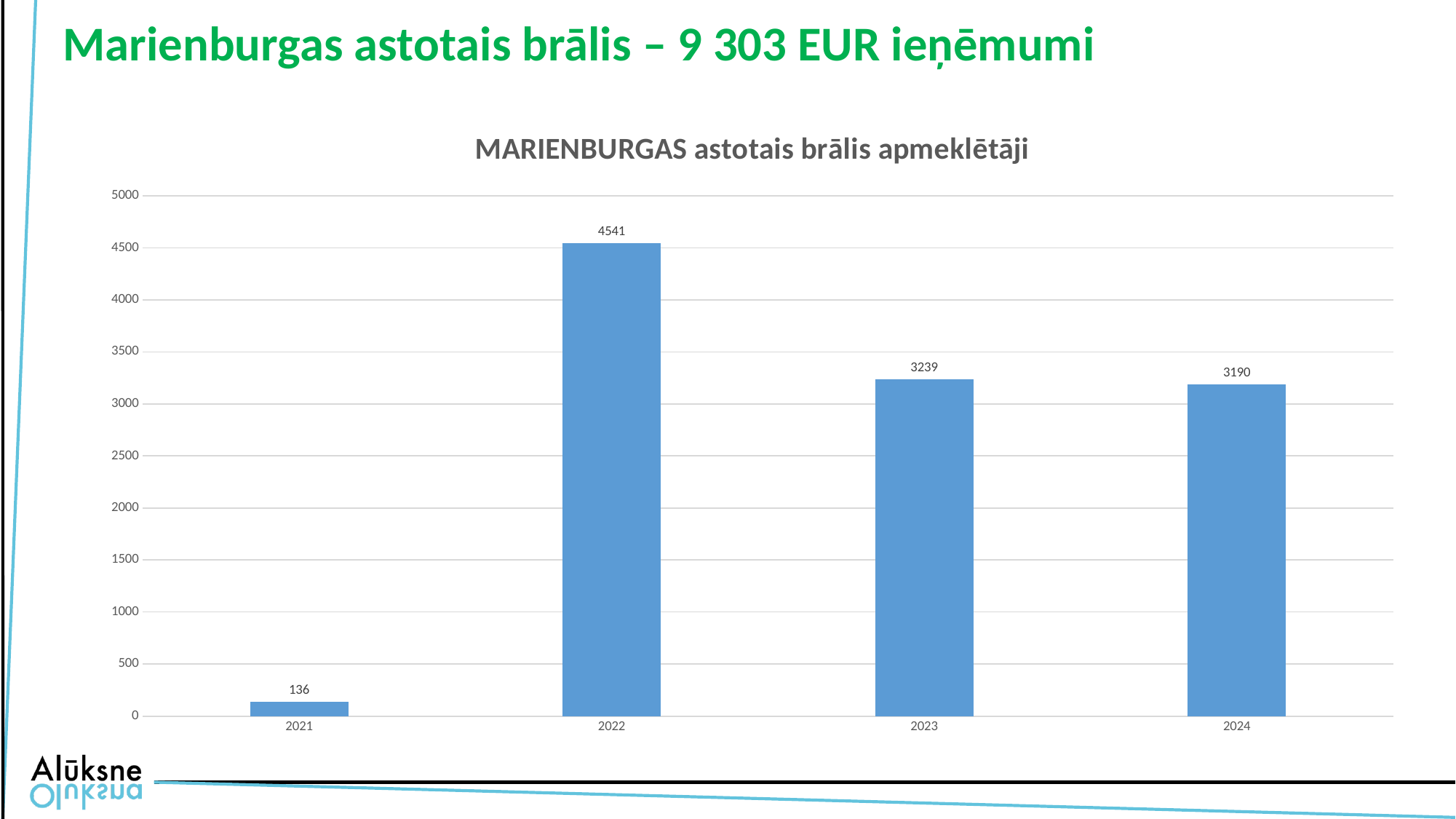
What is the difference between the values for 2022 and 2023? 1302 Which year has the highest value? 2022 What is the value for 2024? 3190 How many years are shown on the x axis? 4 What is the difference between the values for 2023 and 2024? 49 Which year has the lowest value? 2021 Is the value for 2022 greater or less than 4000? greater Which is larger, the value for 2023 or the value for 2024? 2023 What is the title of the chart? MARIENBURGAS astotais brālis apmeklētāji What is the value for 2022? 4541 What is the value for 2021? 136 What kind of chart is shown on the slide? bar chart